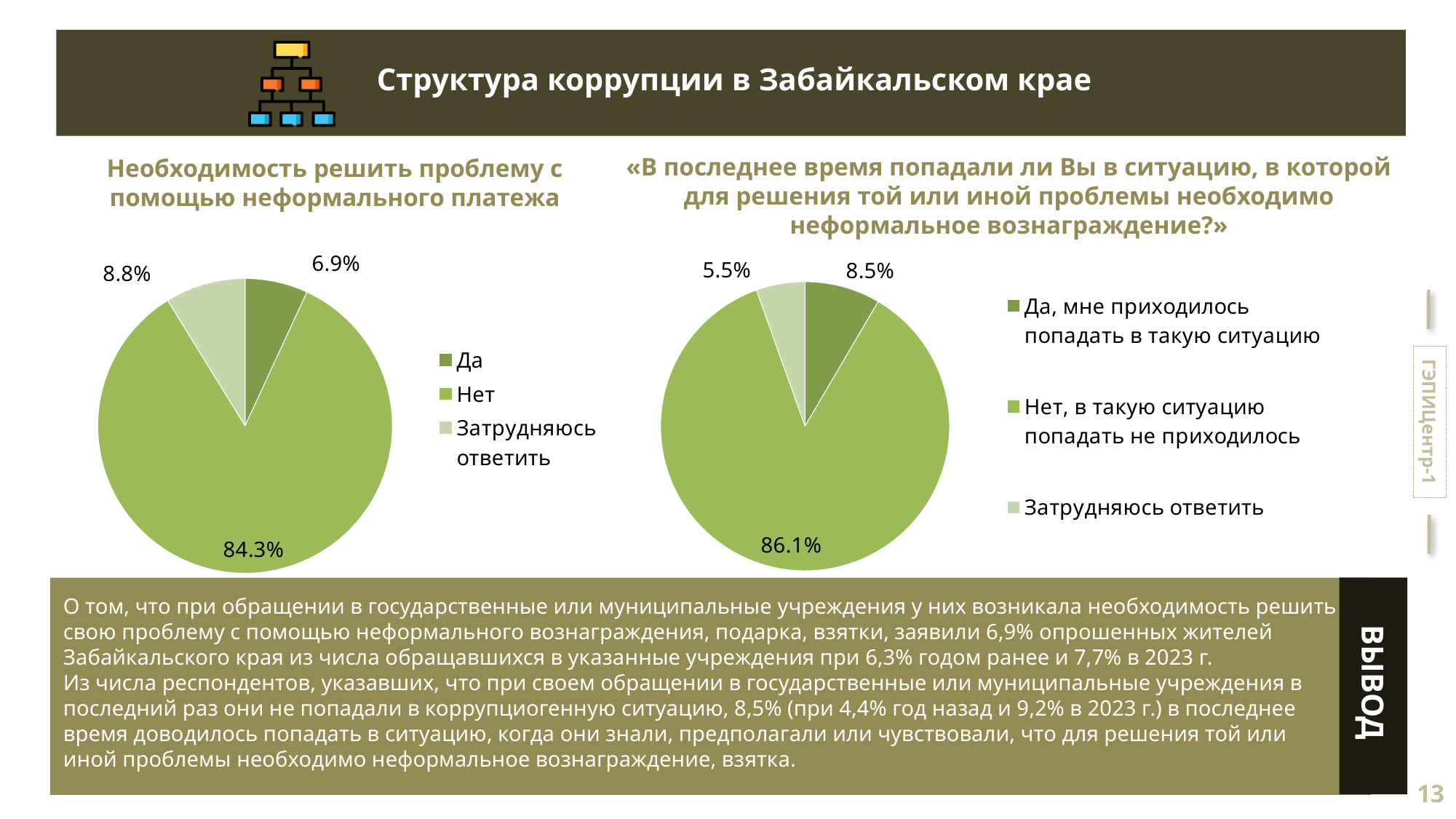
What type of chart is used for the left chart 'Необходимость решить проблему с помощью неформального платежа'? Pie chart In the left chart 'Необходимость решить проблему с помощью неформального платежа', what percentage answered 'Нет'? 84.3% In the right chart about recently encountering a situation requiring informal reward, what percentage chose 'Нет, в такую ситуацию попадать не приходилось'? 86.1% In the right chart about recently encountering a situation requiring informal reward, what share is 'Затрудняюсь ответить'? 5.5% In the left chart 'Необходимость решить проблему с помощью неформального платежа', which answer has the largest share? Нет In the right chart about recently encountering a situation requiring informal reward, which answer has the smallest share? Затрудняюсь ответить In the left chart 'Необходимость решить проблему с помощью неформального платежа', what is the difference between the 'Затрудняюсь ответить' and 'Да' shares? 1.9% In the left chart 'Необходимость решить проблему с помощью неформального платежа', what percentage answered 'Да'? 6.9% In the right chart about recently encountering a situation requiring informal reward, what percentage chose 'Да, мне приходилось попадать в такую ситуацию'? 8.5% In the left chart 'Необходимость решить проблему с помощью неформального платежа', which answer has the smallest share? Да In the right chart about recently encountering a situation requiring informal reward, which is larger: 'Да, мне приходилось попадать в такую ситуацию' or 'Затрудняюсь ответить'? Да, мне приходилось попадать в такую ситуацию In the left chart 'Необходимость решить проблему с помощью неформального платежа', what share is 'Затрудняюсь ответить'? 8.8%